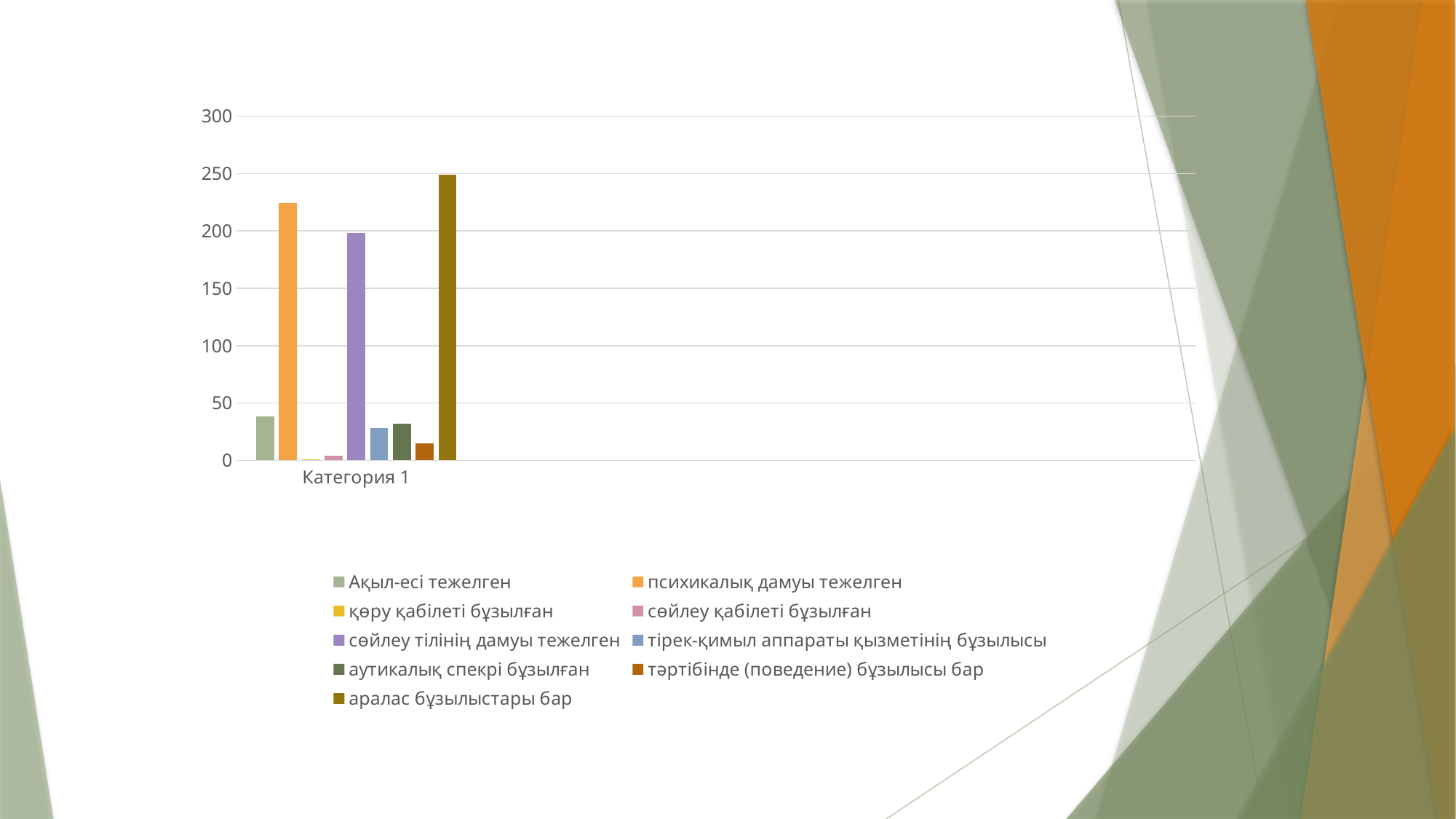
Is the value for тәртібінде (поведение) бұзылысы бар greater or less than 50? less Which series has the highest bar? аралас бұзылыстары бар Is the value for психикалық дамуы тежелген greater or less than 200? greater How many series does the legend list? 9 Which is larger, the value for психикалық дамуы тежелген or the value for сөйлеу тілінің дамуы тежелген? психикалық дамуы тежелген Is the value for Ақыл-есі тежелген greater or less than 50? less What kind of chart is shown on the slide? bar chart Which is larger, the value for Ақыл-есі тежелген or the value for тәртібінде (поведение) бұзылысы бар? Ақыл-есі тежелген What is the label of the category on the x axis? Категория 1 How many categories are shown on the x axis? 1